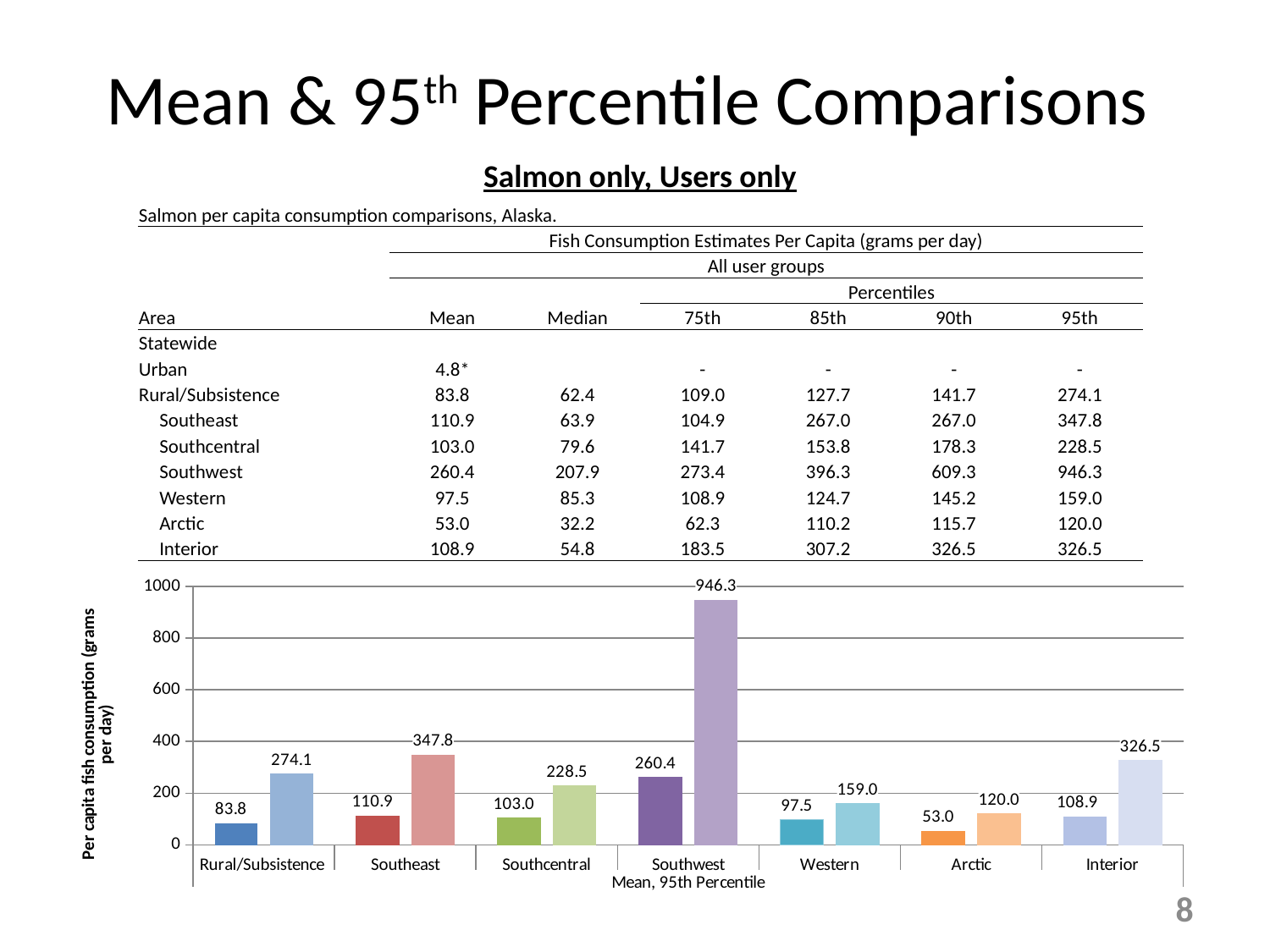
What is the 95th percentile value shown for Southeast in the bar chart? 347.8 Which area has the lowest mean value in the bar chart? Arctic What is the y-axis label of the bar chart? Per capita fish consumption (grams per day) What is the mean value shown for Southwest in the bar chart? 260.4 Which area has the highest 95th percentile value in the bar chart? Southwest What is the difference between the mean values for Southeast and Southcentral in the bar chart? 7.9 What is the 95th percentile value shown for Arctic in the bar chart? 120.0 Is the 95th percentile value for Western in the bar chart greater or less than 200? less How many areas are shown on the x axis of the bar chart? 7 Which is larger in the bar chart: the 95th percentile for Interior or the 95th percentile for Southcentral? Interior What is the difference between the 95th percentile and mean values for Southwest in the bar chart? 685.9 What type of chart is shown on the slide? bar chart